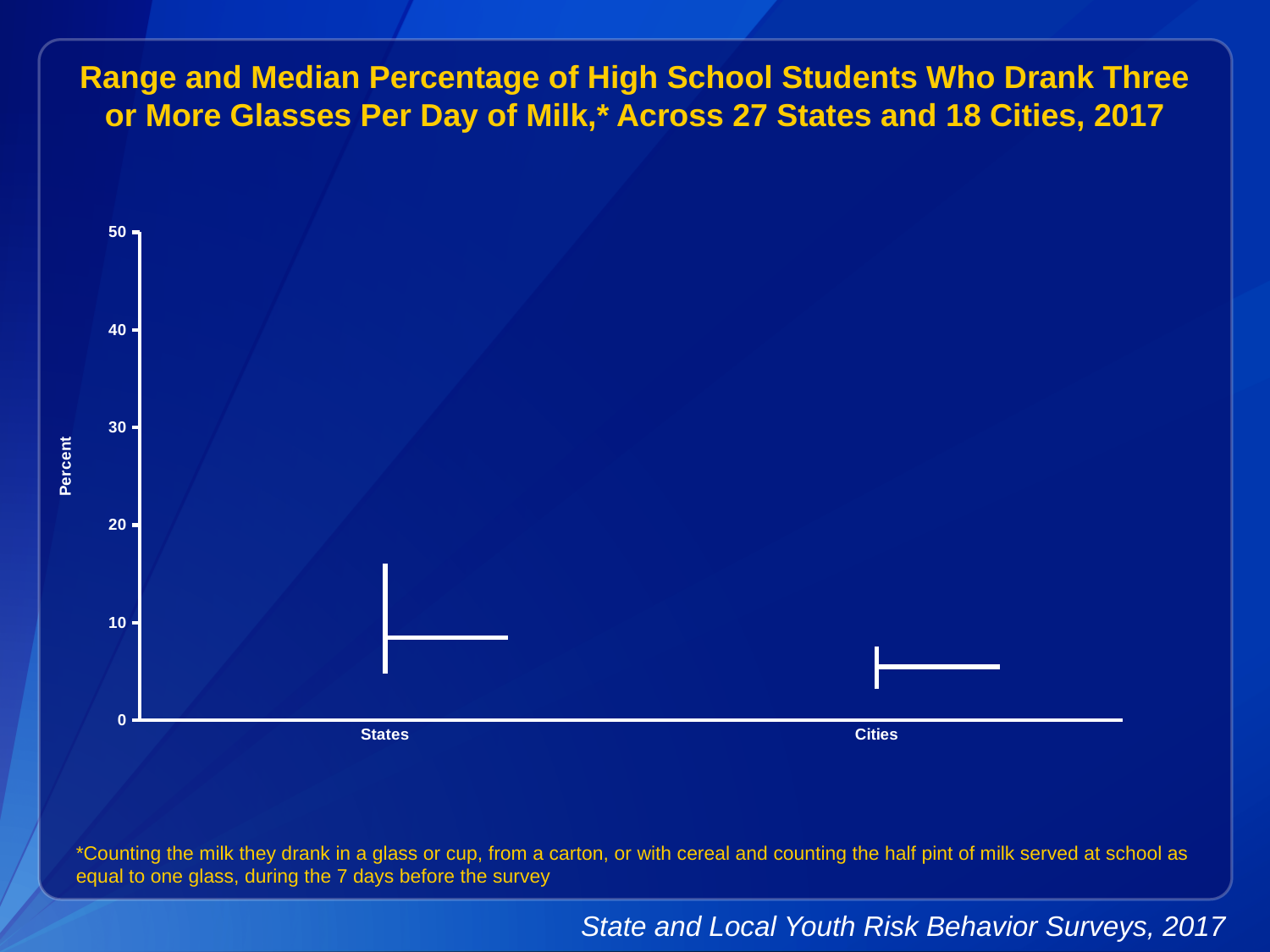
Which has the higher median percentage, States or Cities? States Is the median value for Cities greater or less than 10? less What is the label of the y axis? Percent Is the top of the range for States greater or less than 10? greater Is the bottom of the range for States greater or less than 10? less Which category has the higher top of its range, States or Cities? States How many categories are shown on the x axis? 2 What is the highest value shown on the y axis? 50